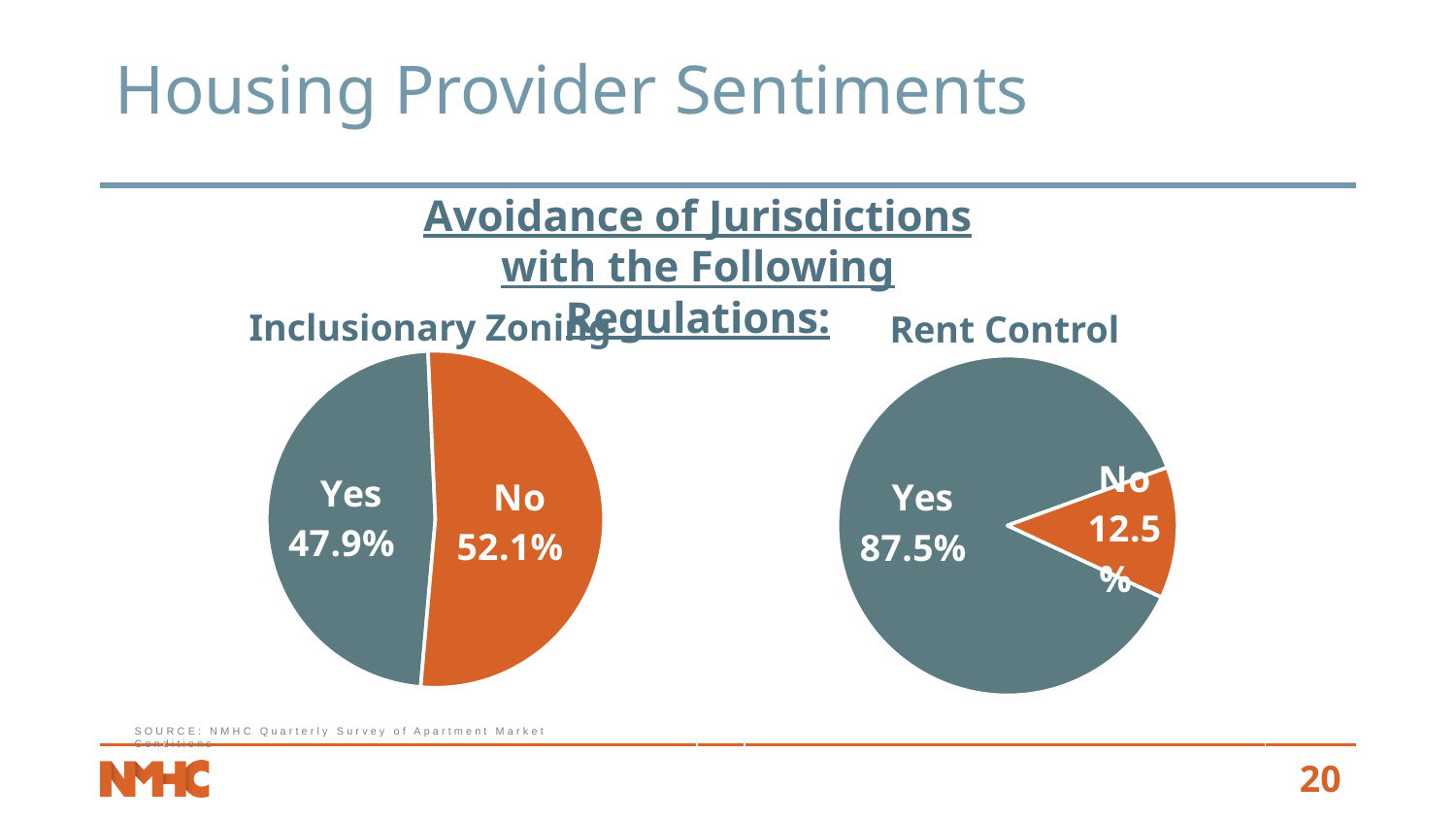
In the Inclusionary Zoning chart, which slice is the smallest? Yes Is the Yes share larger in the Inclusionary Zoning chart or in the Rent Control chart? Rent Control What colour is the No slice in the Rent Control chart? Orange In the Inclusionary Zoning chart, what is the difference between the No and Yes shares? 4.2 percentage points In the Rent Control chart, which slice is the largest? Yes In the Inclusionary Zoning chart, what share of respondents answered No? 52.1% What type of chart is used for the Rent Control data? Pie chart In the Rent Control chart, what share of respondents answered Yes? 87.5% In the Inclusionary Zoning chart, what share of respondents answered Yes? 47.9% In the Rent Control chart, what is the difference between the Yes and No shares? 75 percentage points In the Rent Control chart, what share of respondents answered No? 12.5% How many slices does the Inclusionary Zoning pie chart have? 2